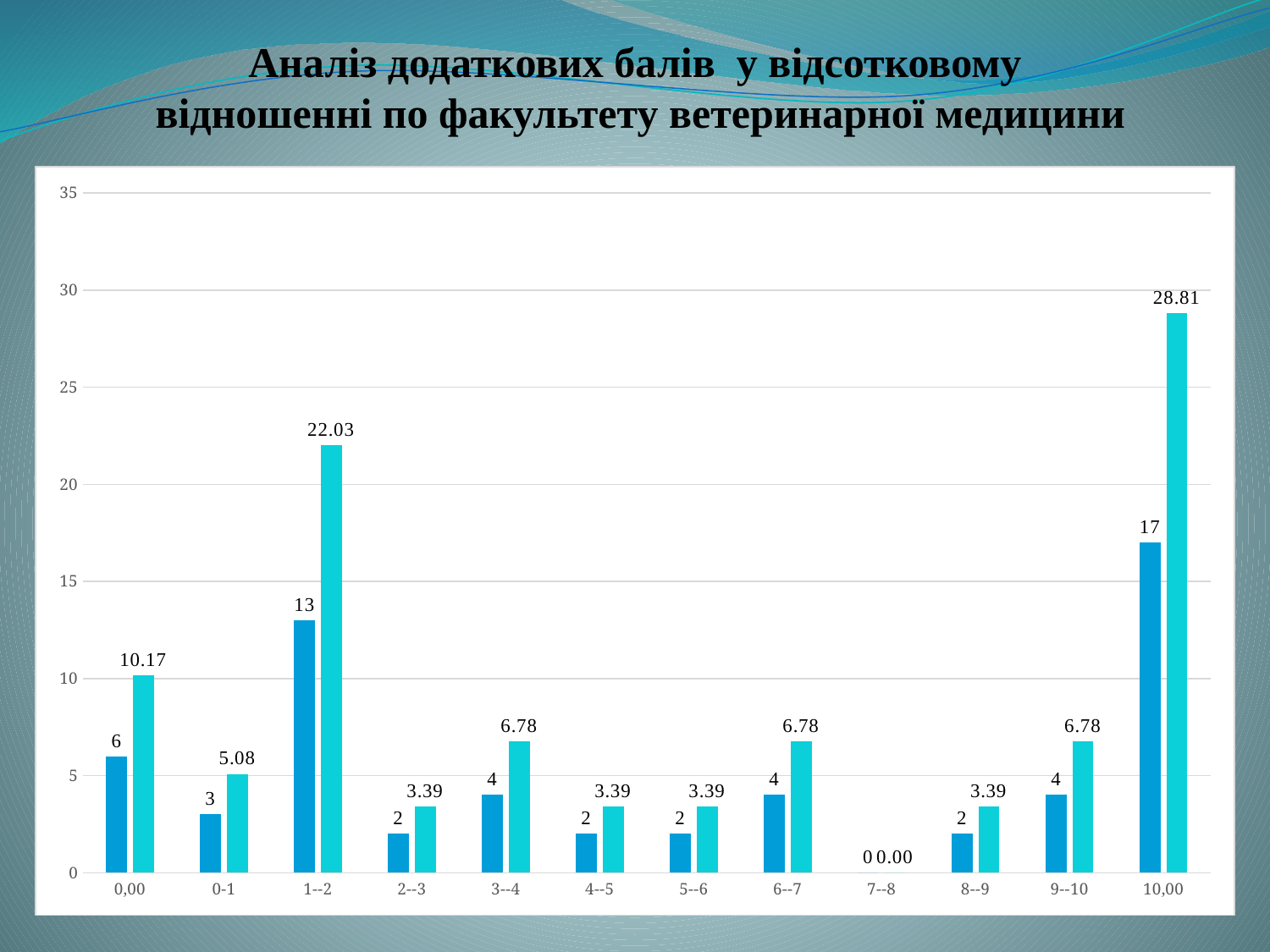
Which is larger, the cyan bar for 0,00 or the cyan bar for 0-1? 0,00 Is the cyan bar for 1--2 greater or less than 20? greater What is the difference between the cyan bars for 10,00 and 1--2? 6.78 What is the value of the dark blue bar for the category 1--2? 13 What is the value of the cyan bar for the category 0,00? 10.17 Which category has the highest cyan bar? 10,00 Which category has the lowest dark blue bar? 7--8 What type of chart is shown on the slide? bar chart How many categories are shown on the x axis? 12 What is the value of the cyan bar for the category 10,00? 28.81 What is the difference between the dark blue bars for 10,00 and 1--2? 4 What is the title of the slide? Аналіз додаткових балів у відсотковому відношенні по факультету ветеринарної медицини